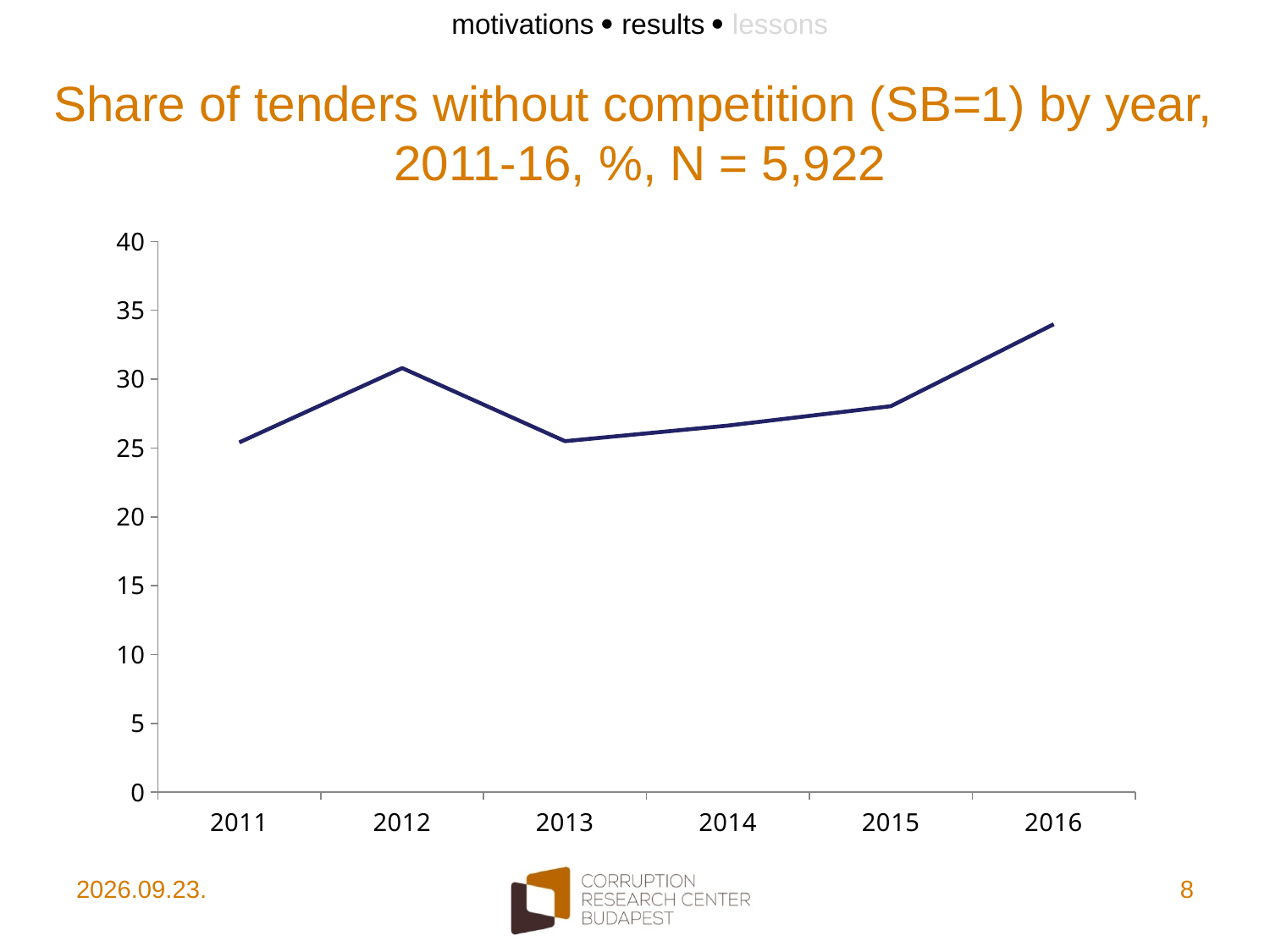
Is the value for 2016 greater or less than 30? greater What is the highest value shown on the y axis of the chart? 40 What is the title of the chart? Share of tenders without competition (SB=1) by year, 2011-16, %, N = 5,922 What kind of chart is shown on the slide? line chart How many years are plotted on the x axis of the chart? 6 Do the values rise or fall from 2013 to 2016? rise Which is larger, the value for 2016 or the value for 2012? 2016 Is the value for 2015 greater or less than 25? greater Which is larger, the value for 2012 or the value for 2013? 2012 Is the value for 2011 greater or less than 30? less Which year has the highest share of tenders without competition? 2016